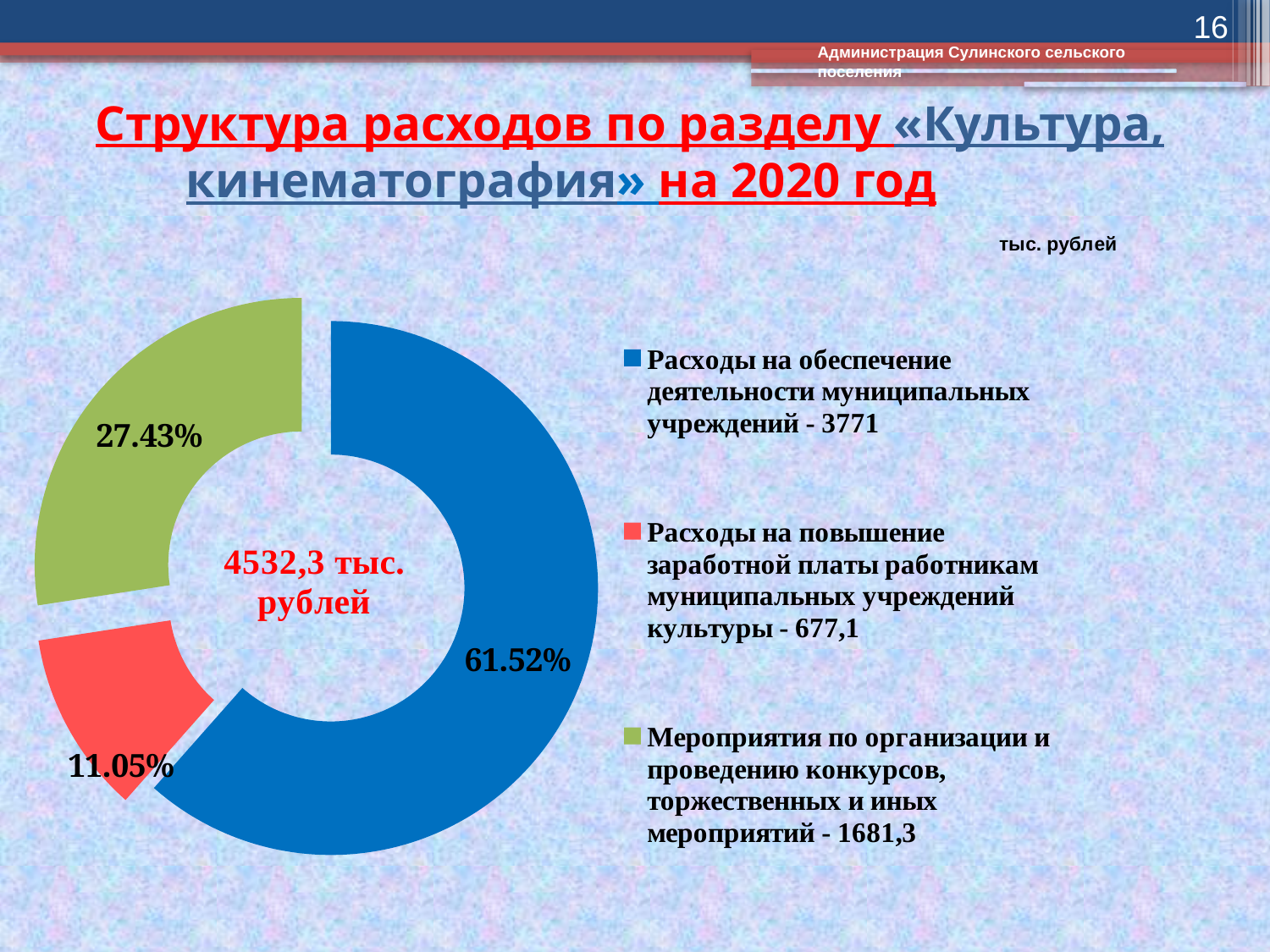
What value (тыс. рублей) is given in the legend for 'Мероприятия по организации и проведению конкурсов, торжественных и иных мероприятий'? 1681,3 How many slices does the doughnut chart have? 3 What share of the chart is labelled for 'Мероприятия по организации и проведению конкурсов, торжественных и иных мероприятий'? 27.43% Which category has the largest share of the chart? Расходы на обеспечение деятельности муниципальных учреждений How many entries does the legend list? 3 What kind of chart is shown on the slide? Doughnut (pie) chart What share of the chart is labelled for 'Расходы на обеспечение деятельности муниципальных учреждений'? 61.52% What share of the chart is labelled for 'Расходы на повышение заработной платы работникам муниципальных учреждений культуры'? 11.05% What value (тыс. рублей) is given in the legend for 'Расходы на обеспечение деятельности муниципальных учреждений'? 3771 What colour is the slice for 'Мероприятия по организации и проведению конкурсов, торжественных и иных мероприятий'? Green What total amount is shown in the centre of the doughnut chart? 4532,3 тыс. рублей Which category has the smallest share of the chart? Расходы на повышение заработной платы работникам муниципальных учреждений культуры